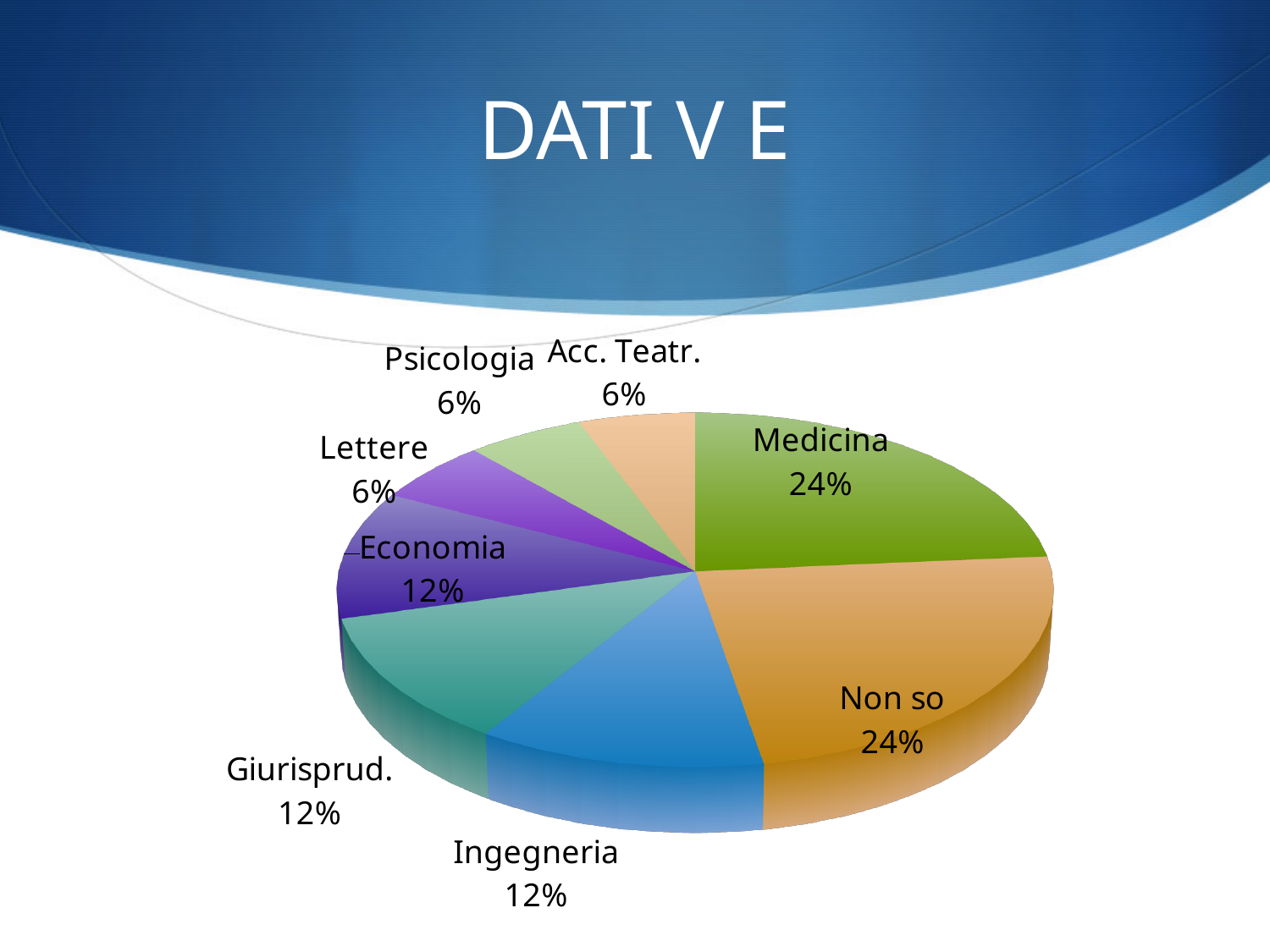
What is the title of the slide's chart? DATI V E What percentage does the Acc. Teatr. slice represent? 6% What percentage does the Medicina slice represent? 24% What kind of chart is shown on the slide? pie chart What percentage does the Lettere slice represent? 6% What is the difference in percentage points between the Non so slice and the Psicologia slice? 18% Which is larger, the Ingegneria slice or the Lettere slice? Ingegneria Which is larger, the Medicina slice or the Economia slice? Medicina How many slices does the pie chart have? 8 What share of the pie does Giurisprud. take? 12% What percentage does the Non so slice represent? 24% What percentage does the Ingegneria slice represent? 12%